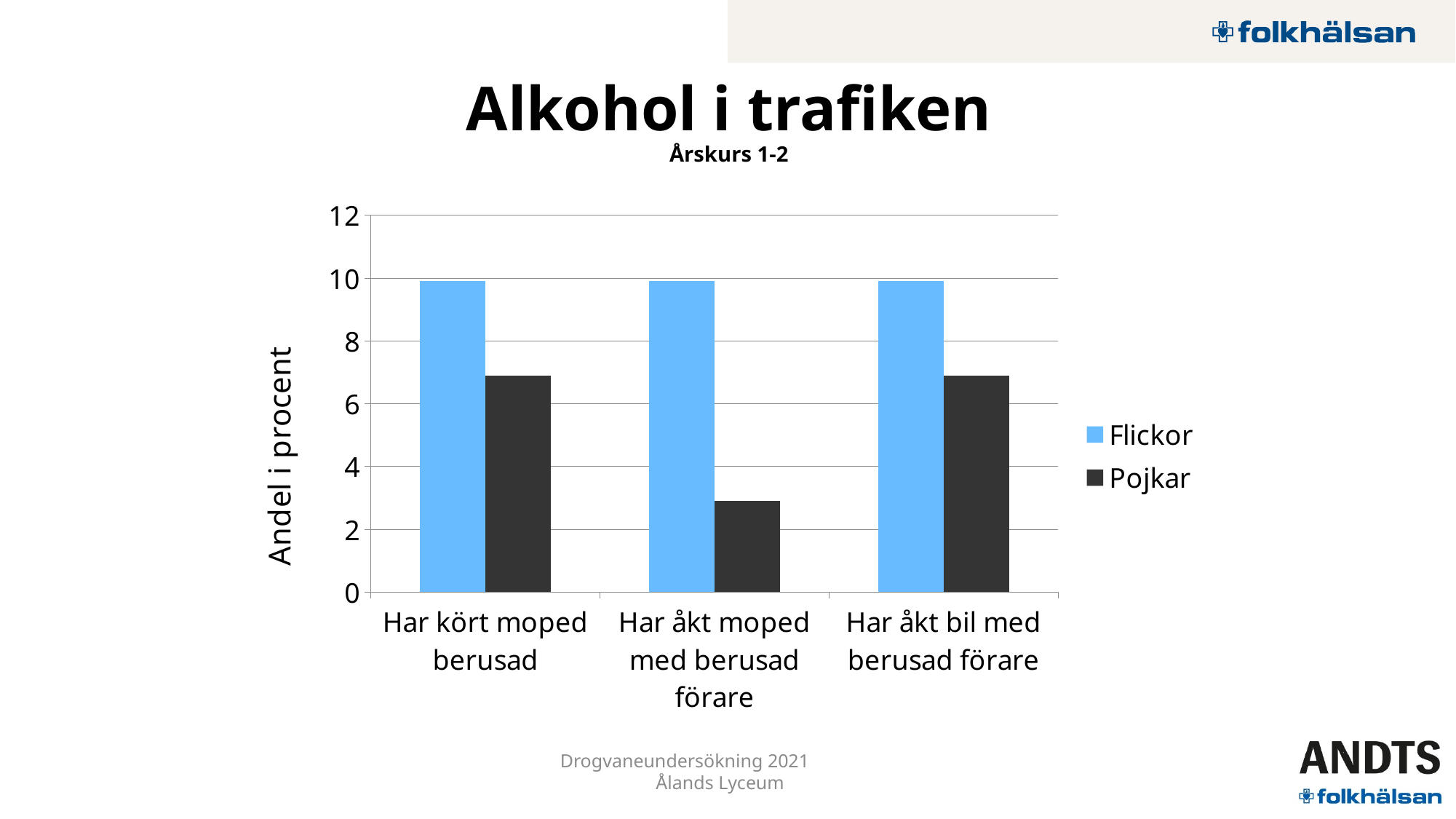
Is the Flickor value for 'Har åkt moped med berusad förare' greater or less than 8? greater Is the Pojkar value for 'Har åkt moped med berusad förare' greater or less than 4? less For the Pojkar series, which category has the lowest value? Har åkt moped med berusad förare What is the label on the y axis of the chart? Andel i procent Is the Pojkar value for 'Har kört moped berusad' greater or less than 6? greater Which series has the lowest value for 'Har åkt moped med berusad förare'? Pojkar How many series does the chart's legend list? 2 What kind of chart is shown on the slide? bar chart For 'Har kört moped berusad', which series has the larger value, Flickor or Pojkar? Flickor Which series is shown in light blue in the chart? Flickor How many categories are shown on the x axis of the chart? 3 For 'Har åkt bil med berusad förare', which series has the larger value, Flickor or Pojkar? Flickor